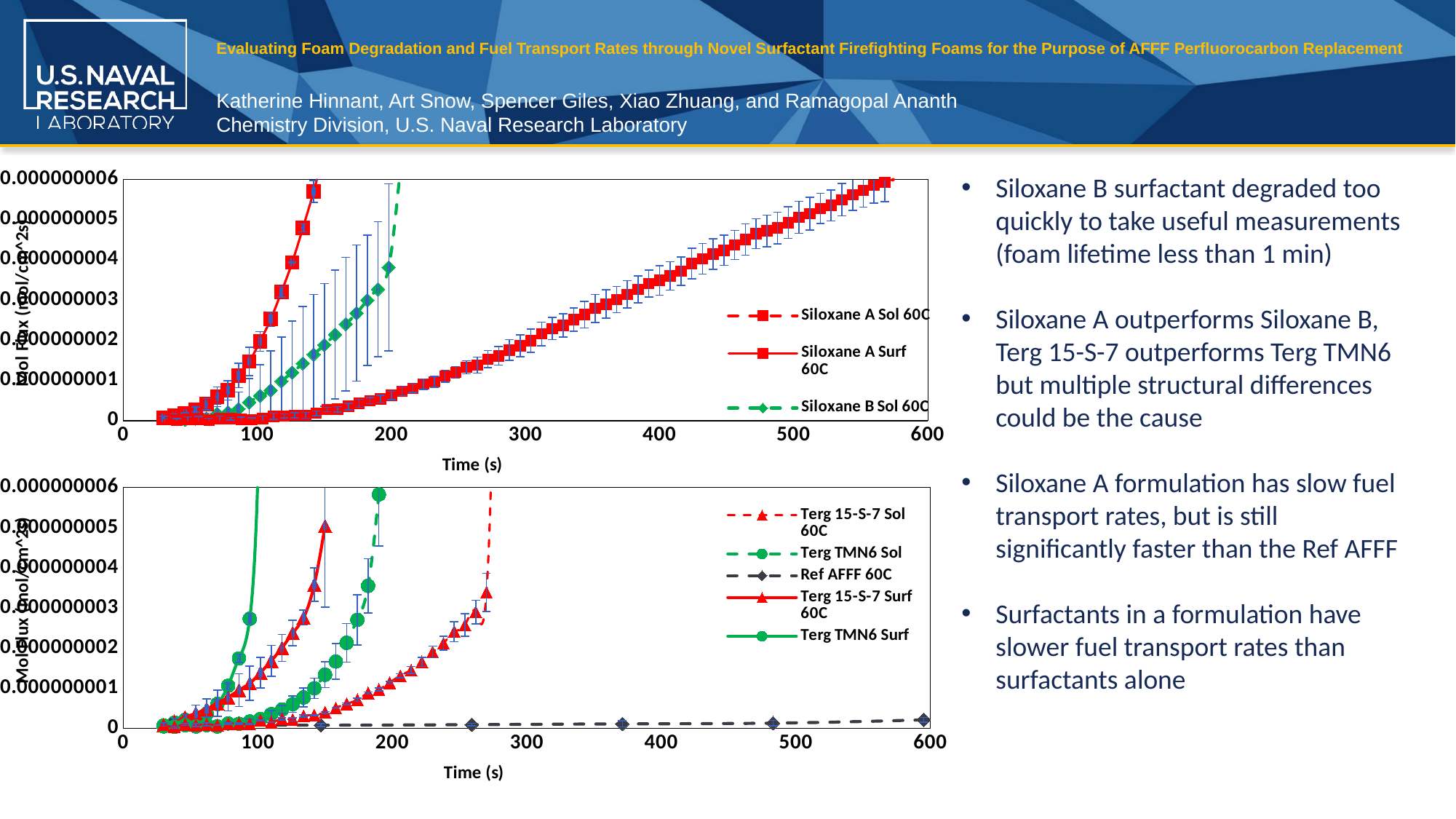
In the top chart, what is the x-axis title? Time (s) In the bottom chart, at 100 s, which is larger: Terg TMN6 Surf or Terg 15-S-7 Surf 60C? Terg TMN6 Surf How many series does the legend of the bottom chart list? 5 In the bottom chart, which legend entry is drawn with a dashed grey line and diamond markers? Ref AFFF 60C In the top chart, is the value for Siloxane A Sol 60C at 400 s greater or less than 0.000000003? greater In the bottom chart, is the value for Ref AFFF 60C at 600 s greater or less than 0.000000001? less In the bottom chart, does the Terg TMN6 Surf series rise or fall as time increases? rise In the top chart, at 100 s, which is larger: Siloxane A Surf 60C or Siloxane B Sol 60C? Siloxane A Surf 60C In the bottom chart, which series has the lowest values across the whole time range? Ref AFFF 60C How many series does the legend of the top chart list? 3 What kind of chart is the top chart on the slide? line chart In the top chart, does the Siloxane A Sol 60C series rise or fall as time increases? rise